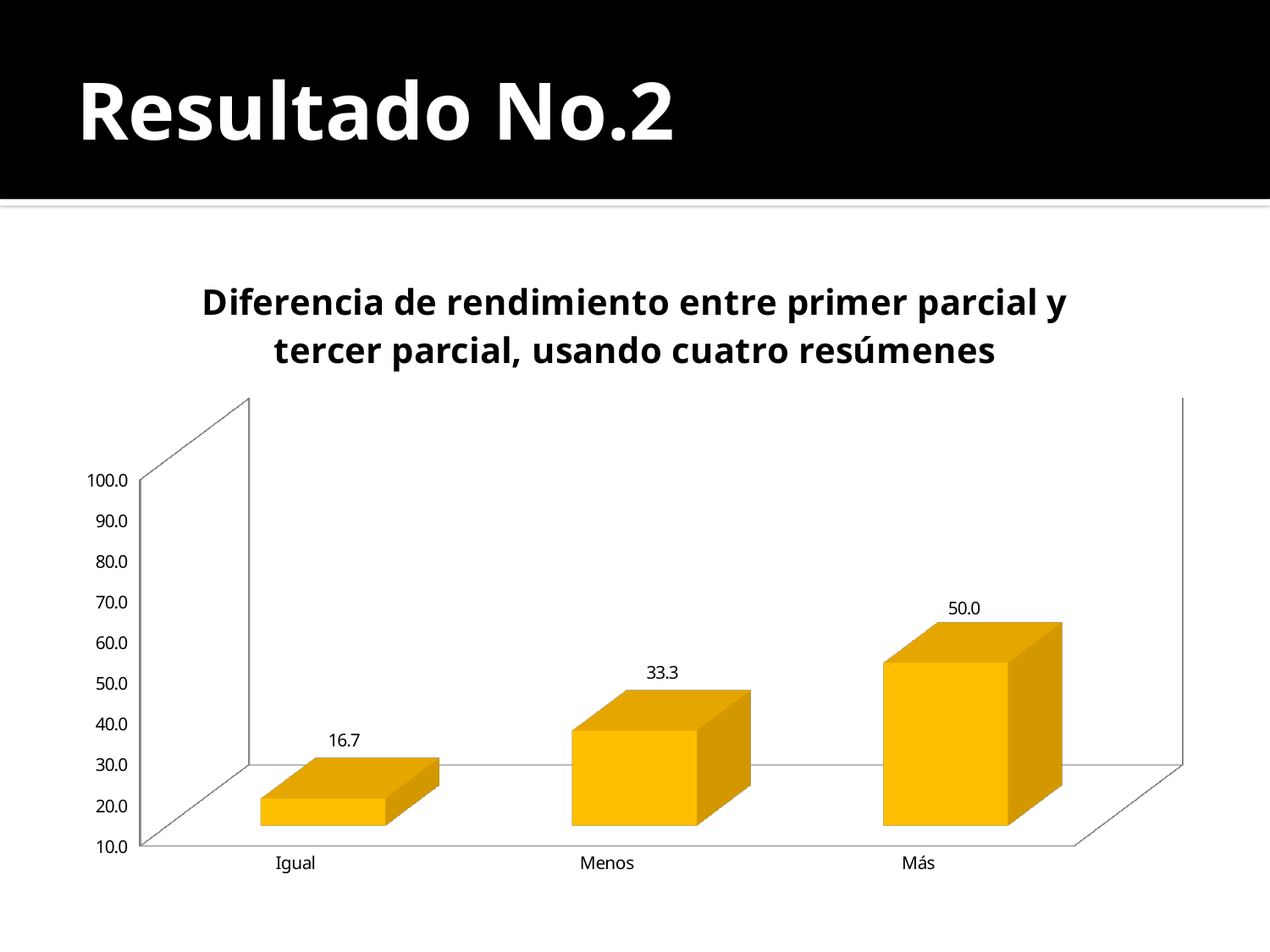
What is the value for Menos? 33.3 What is the difference between the values for Menos and Igual? 16.6 Which category has the lowest value? Igual How many categories are shown on the x axis? 3 What kind of chart is shown on the slide? Bar chart Do the values rise or fall from left to right along the x axis? Rise What is the value for Más? 50.0 Which is larger, the value for Menos or the value for Igual? Menos What is the difference between the values for Más and Igual? 33.3 What is the value for Igual? 16.7 Which category has the highest value? Más What is the title of the chart? Diferencia de rendimiento entre primer parcial y tercer parcial, usando cuatro resúmenes